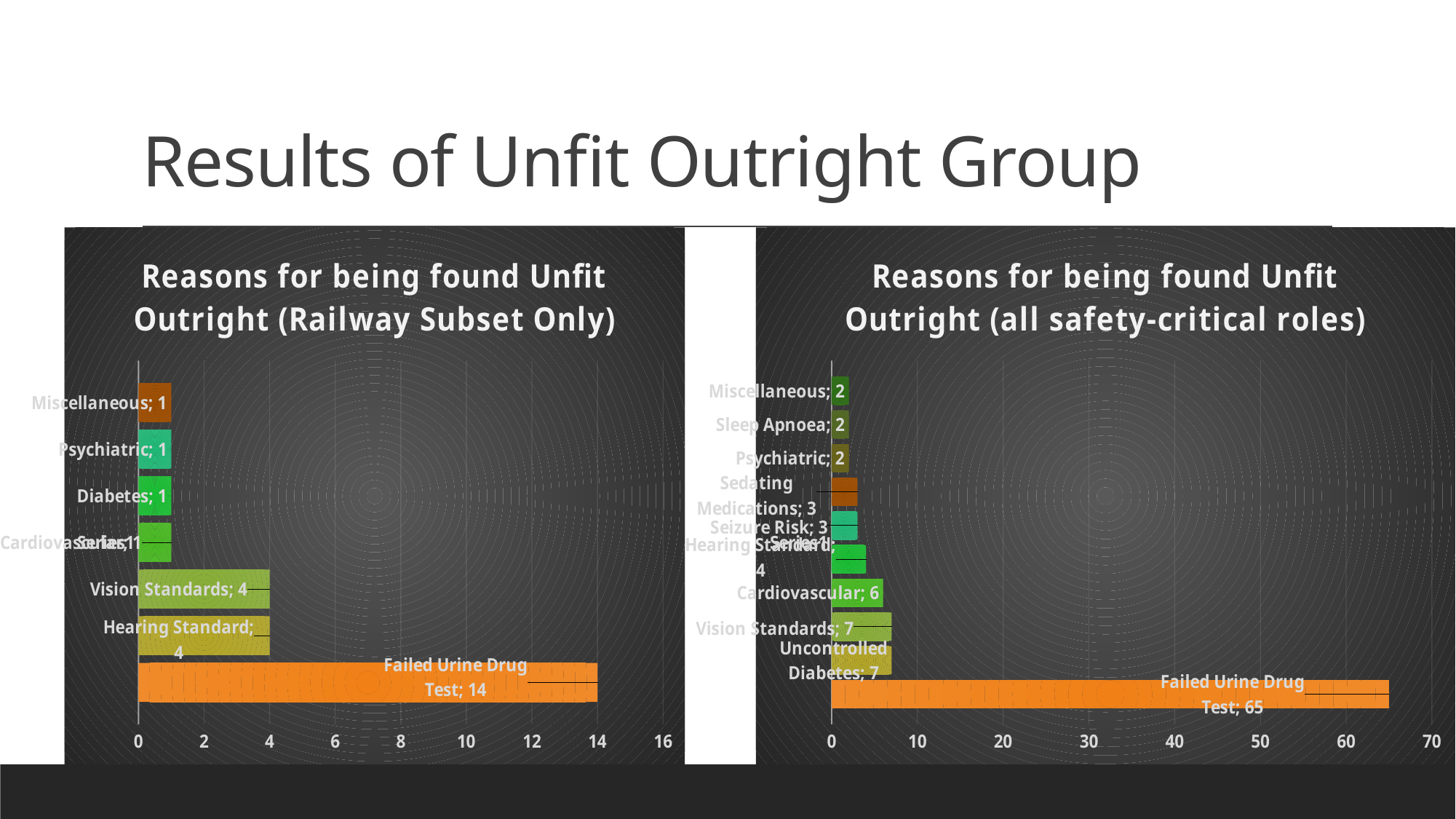
In the chart titled "Reasons for being found Unfit Outright (Railway Subset Only)", what is the difference between Failed Urine Drug Test and Hearing Standard? 10 What kind of chart is the chart on the right of the slide? Bar chart In the chart titled "Reasons for being found Unfit Outright (Railway Subset Only)", which category has the highest value? Failed Urine Drug Test In the chart titled "Reasons for being found Unfit Outright (Railway Subset Only)", what is the value for Failed Urine Drug Test? 14 In the chart titled "Reasons for being found Unfit Outright (all safety-critical roles)", what is the value for Seizure Risk? 3 In the chart titled "Reasons for being found Unfit Outright (all safety-critical roles)", is the value for Failed Urine Drug Test greater or less than 60? greater In the chart titled "Reasons for being found Unfit Outright (all safety-critical roles)", what is the difference between Failed Urine Drug Test and Uncontrolled Diabetes? 58 In the chart titled "Reasons for being found Unfit Outright (Railway Subset Only)", how many bars are plotted? 7 In the chart titled "Reasons for being found Unfit Outright (Railway Subset Only)", what is the value for Vision Standards? 4 In the chart titled "Reasons for being found Unfit Outright (all safety-critical roles)", which is larger, Vision Standards or Cardiovascular? Vision Standards In the chart titled "Reasons for being found Unfit Outright (all safety-critical roles)", what is the value for Failed Urine Drug Test? 65 In the chart titled "Reasons for being found Unfit Outright (all safety-critical roles)", what is the value for Cardiovascular? 6